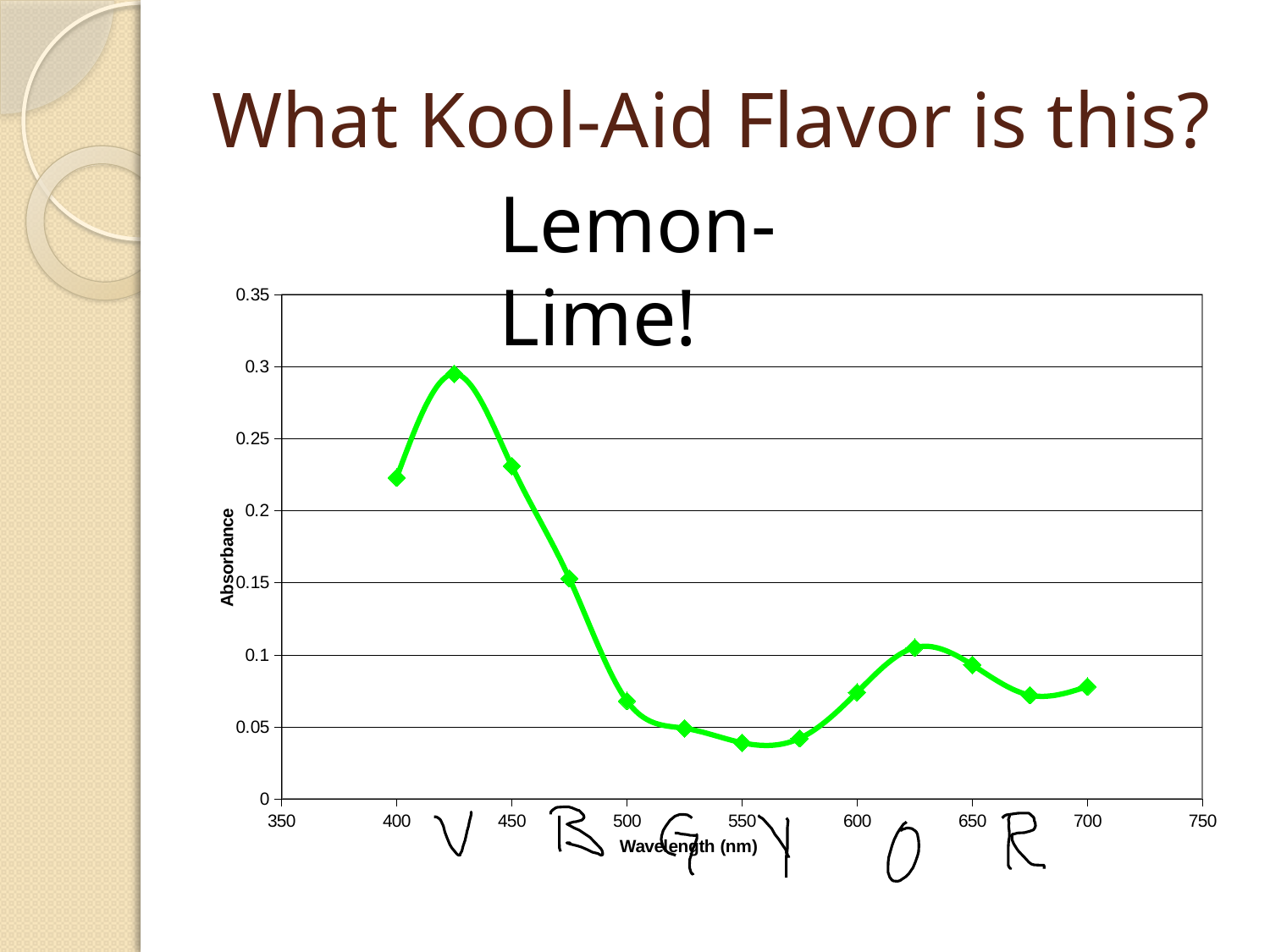
Is the absorbance at 400 nm greater or less than 0.2? greater Is the absorbance at 550 nm greater or less than 0.05? less Is the absorbance at 700 nm greater or less than 0.1? less Does the absorbance rise or fall as the wavelength goes from 450 nm to 550 nm? fall Does the peak absorbance occur below or above 500 nm? below Which has the higher absorbance, 400 nm or 700 nm? 400 nm What kind of chart is shown on the slide? line chart What is the title of the y axis? Absorbance How many data points are plotted on the line? 13 What is the title of the x axis? Wavelength (nm)